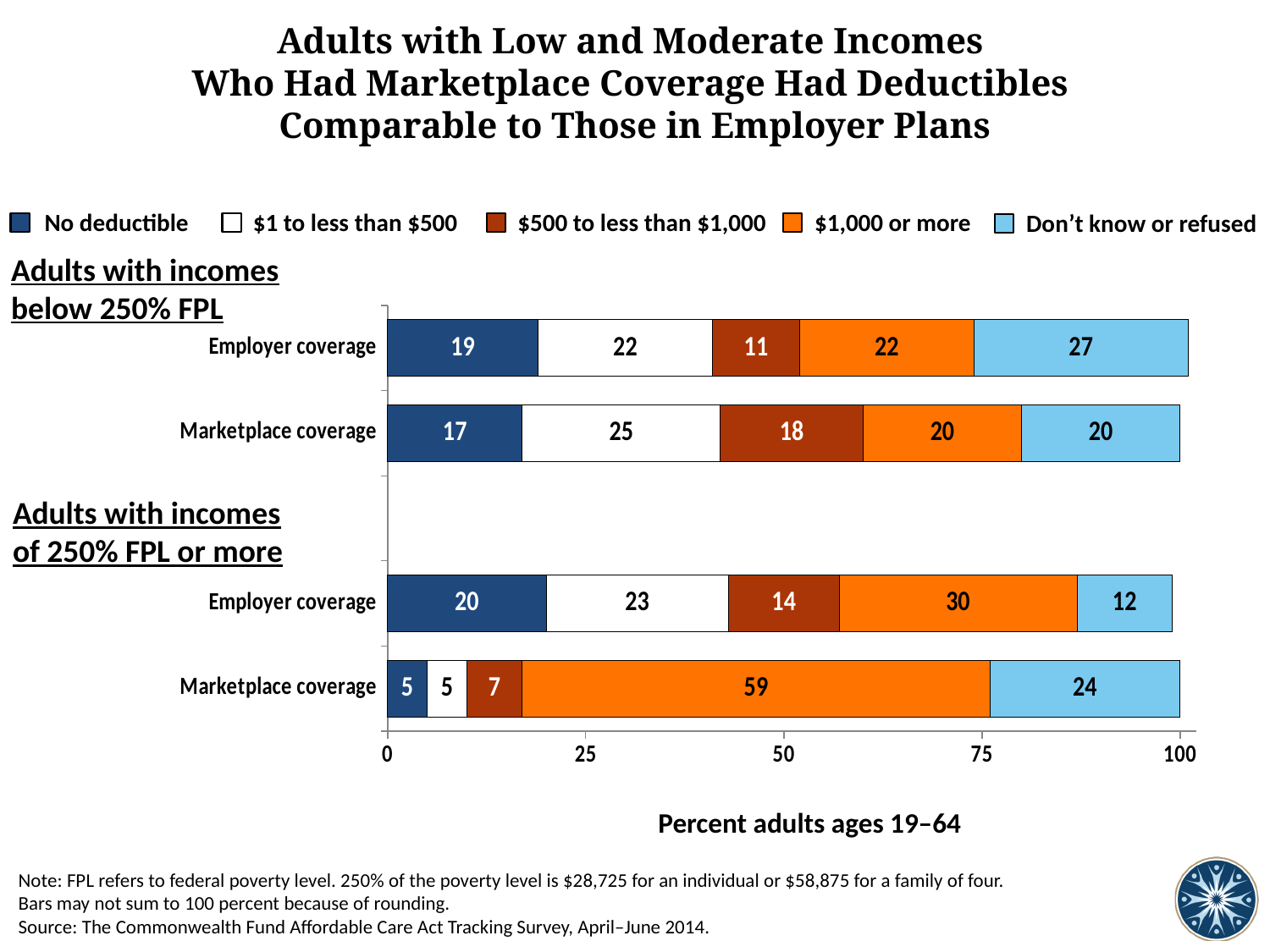
For adults with incomes of 250% FPL or more, what is the value for "$1,000 or more" in the Marketplace coverage bar? 59 For adults with incomes of 250% FPL or more, what is the difference between the "$1,000 or more" values for Marketplace coverage and Employer coverage? 29 For adults with incomes below 250% FPL, what is the value for "$1,000 or more" in the Employer coverage bar? 22 For adults with incomes below 250% FPL, which is larger: the "Don't know or refused" value for Employer coverage or for Marketplace coverage? Employer coverage For adults with incomes below 250% FPL, what is the value for "$500 to less than $1,000" in the Marketplace coverage bar? 18 What is the x-axis label of the chart? Percent adults ages 19–64 How many series does the legend list? 5 For adults with incomes of 250% FPL or more, what is the value for "Don't know or refused" in the Employer coverage bar? 12 What kind of chart is shown on the slide? Stacked bar chart Which bar has the smallest "No deductible" segment? Marketplace coverage, adults with incomes of 250% FPL or more Which bar has the largest "$1,000 or more" segment? Marketplace coverage, adults with incomes of 250% FPL or more How many bars are plotted in the chart? 4